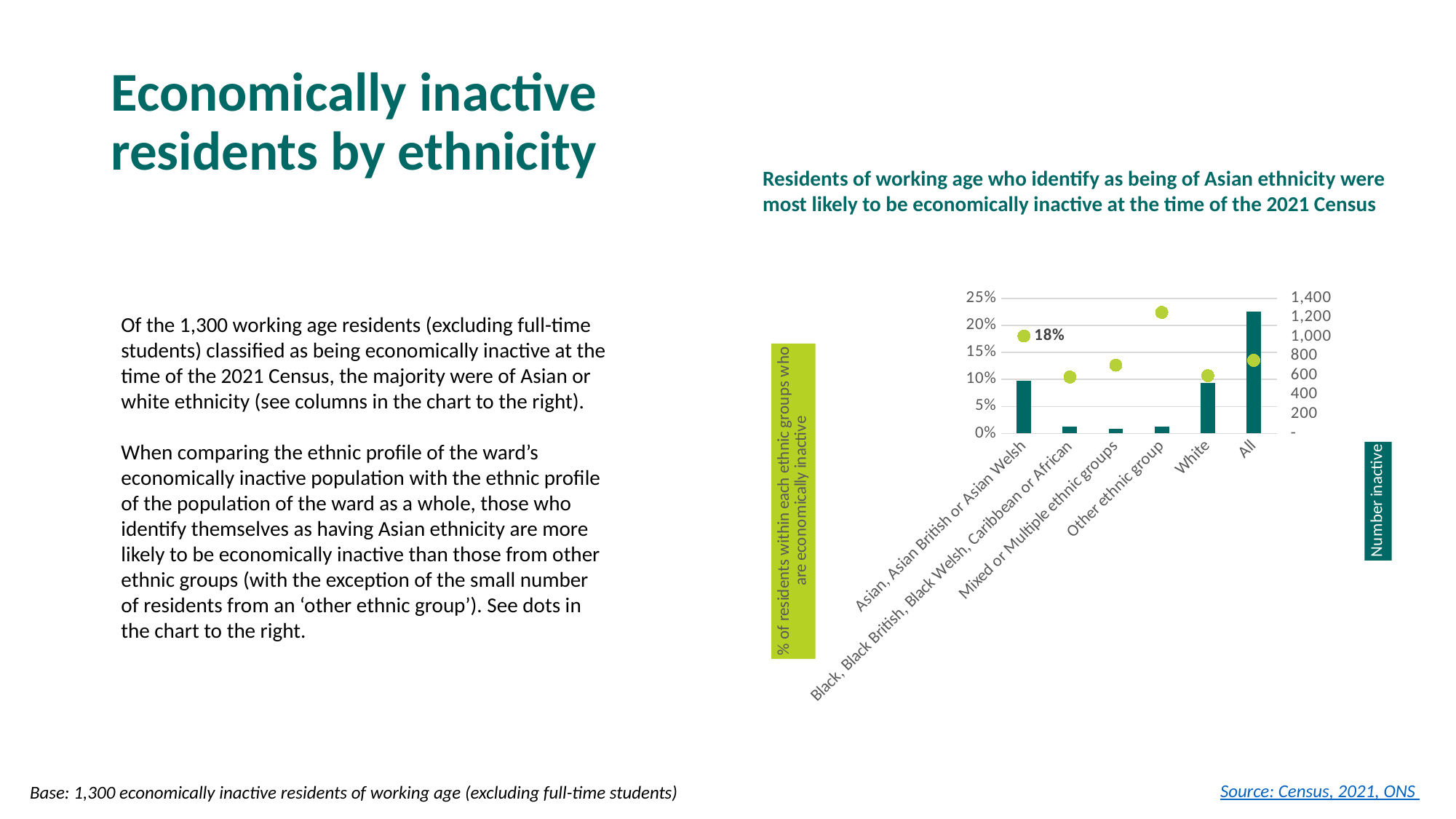
Which has a higher percentage of economically inactive residents: the Asian, Asian British or Asian Welsh group or the White group? Asian, Asian British or Asian Welsh What kind of chart is shown on the slide? Bar chart with dot markers How many categories are shown on the x axis of the chart? 6 What is the label of the right-hand axis of the chart? Number inactive Is the number inactive for the All category greater or less than 1,000? greater Is the number inactive for the Asian, Asian British or Asian Welsh group greater or less than 400? greater Which category has the tallest bar for number inactive? All Is the percentage economically inactive for White residents greater or less than 15%? less What is the label of the left-hand axis of the chart? % of residents within each ethnic groups who are economically inactive Which ethnic group has the highest percentage of economically inactive residents (the dots)? Other ethnic group What percentage of residents in the Asian, Asian British or Asian Welsh group are economically inactive? 18%